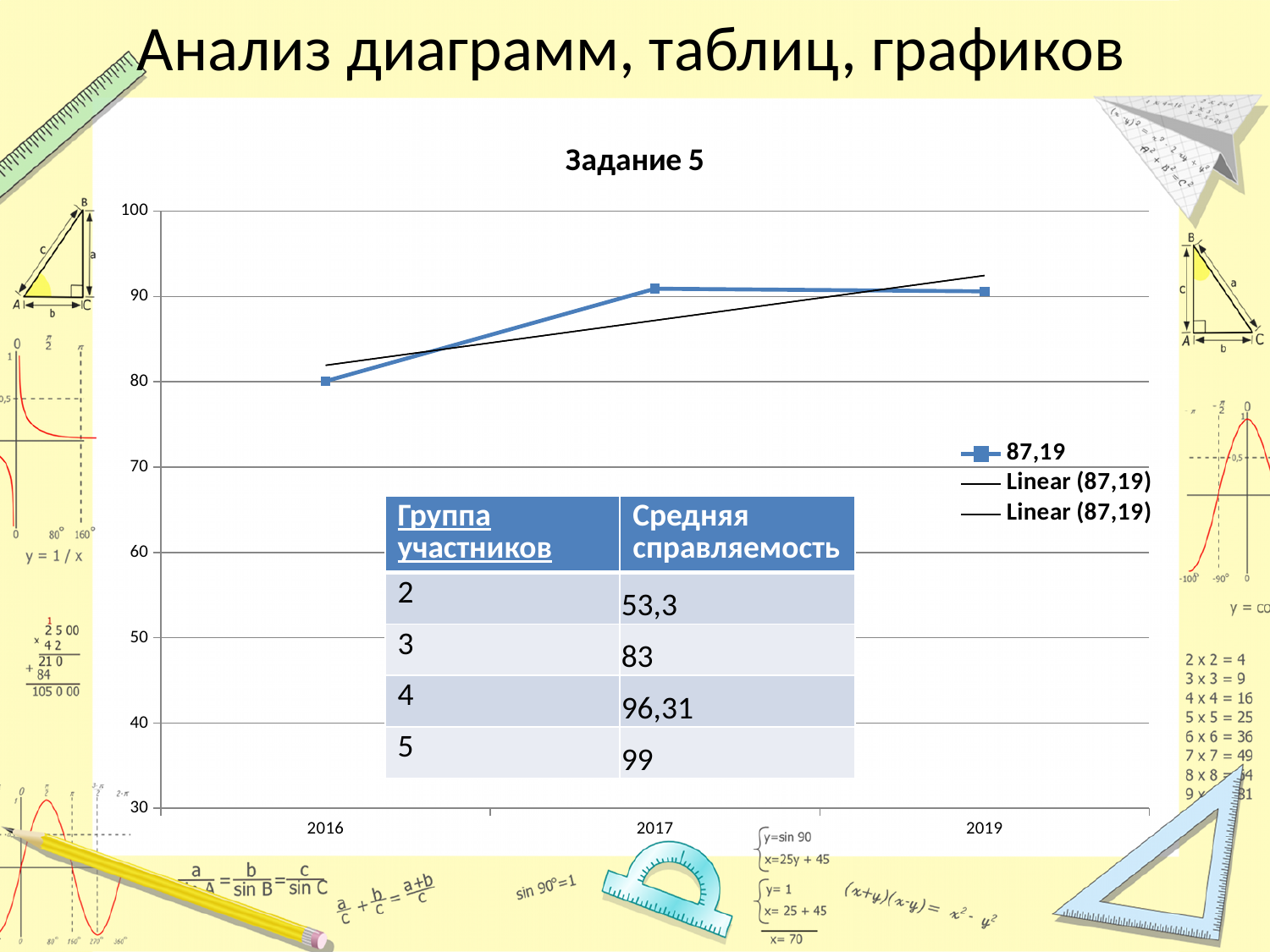
Which years are labelled on the x axis? 2016, 2017, 2019 Is the value for 2019 greater or less than 80? greater What is the title of the chart? Задание 5 Which is larger, the value for 2016 or the value for 2017? 2017 What kind of chart is shown on the slide? line chart How many entries does the chart legend list? 3 What is the name of the plotted data series shown in the legend? 87,19 Is the value for 2017 greater or less than 90? greater Is the value for 2016 greater or less than 90? less Does the line rise or fall from 2016 to 2017? rise Which year has the lowest value on the line? 2016 How many data points are plotted on the line? 3